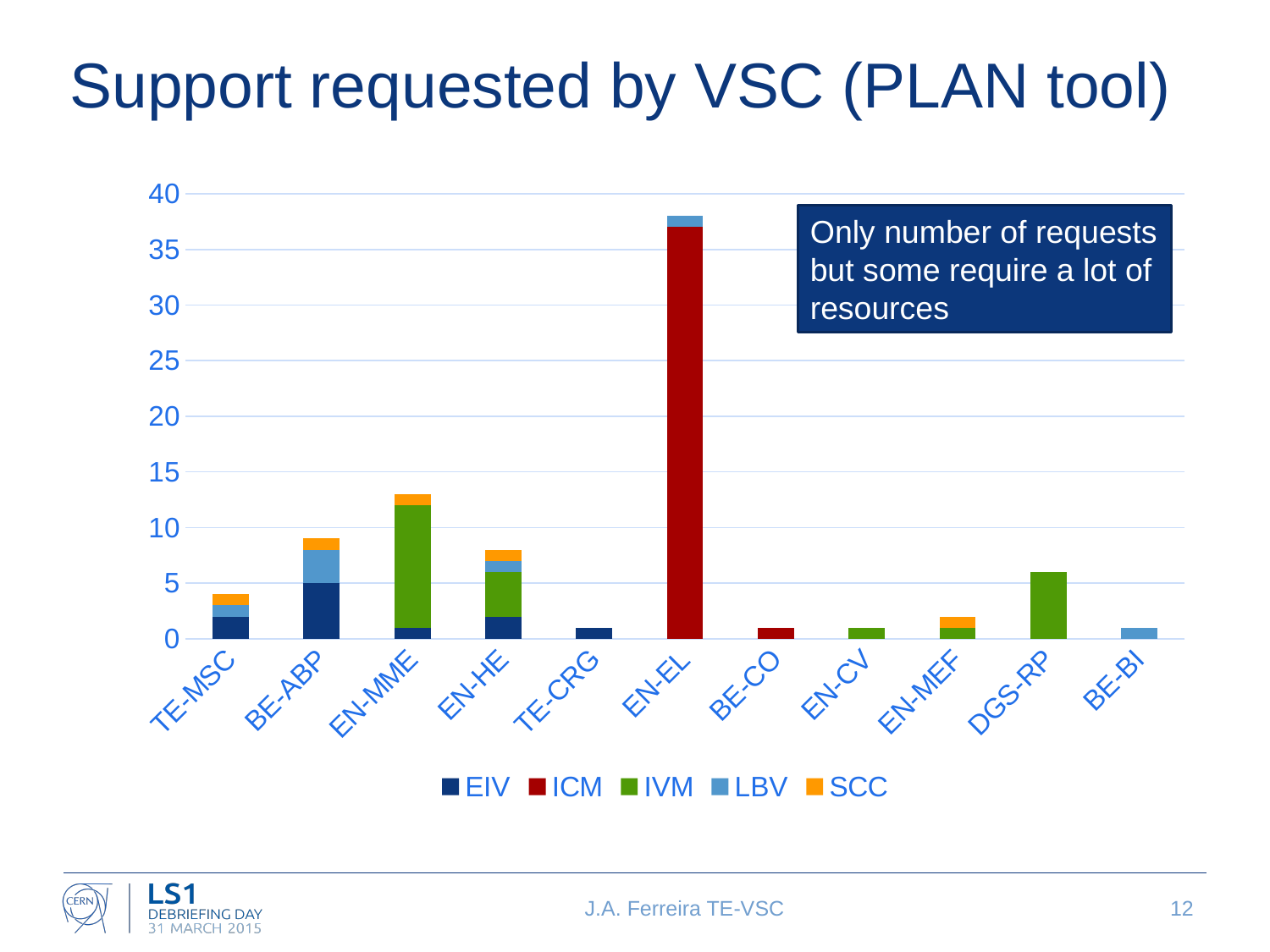
Is the total value for EN-EL greater or less than 35? greater Is the total value for EN-MME greater or less than 10? greater Which has a larger total, EN-MME or BE-ABP? EN-MME How many series does the chart legend list? 5 What kind of chart is shown on the slide? Stacked bar chart Which series is shown in red in the chart? ICM What is the title of the slide containing the chart? Support requested by VSC (PLAN tool) Is the total value for TE-MSC greater or less than 5? less How many categories are shown along the x axis of the chart? 11 Which category has the highest total number of requests? EN-EL